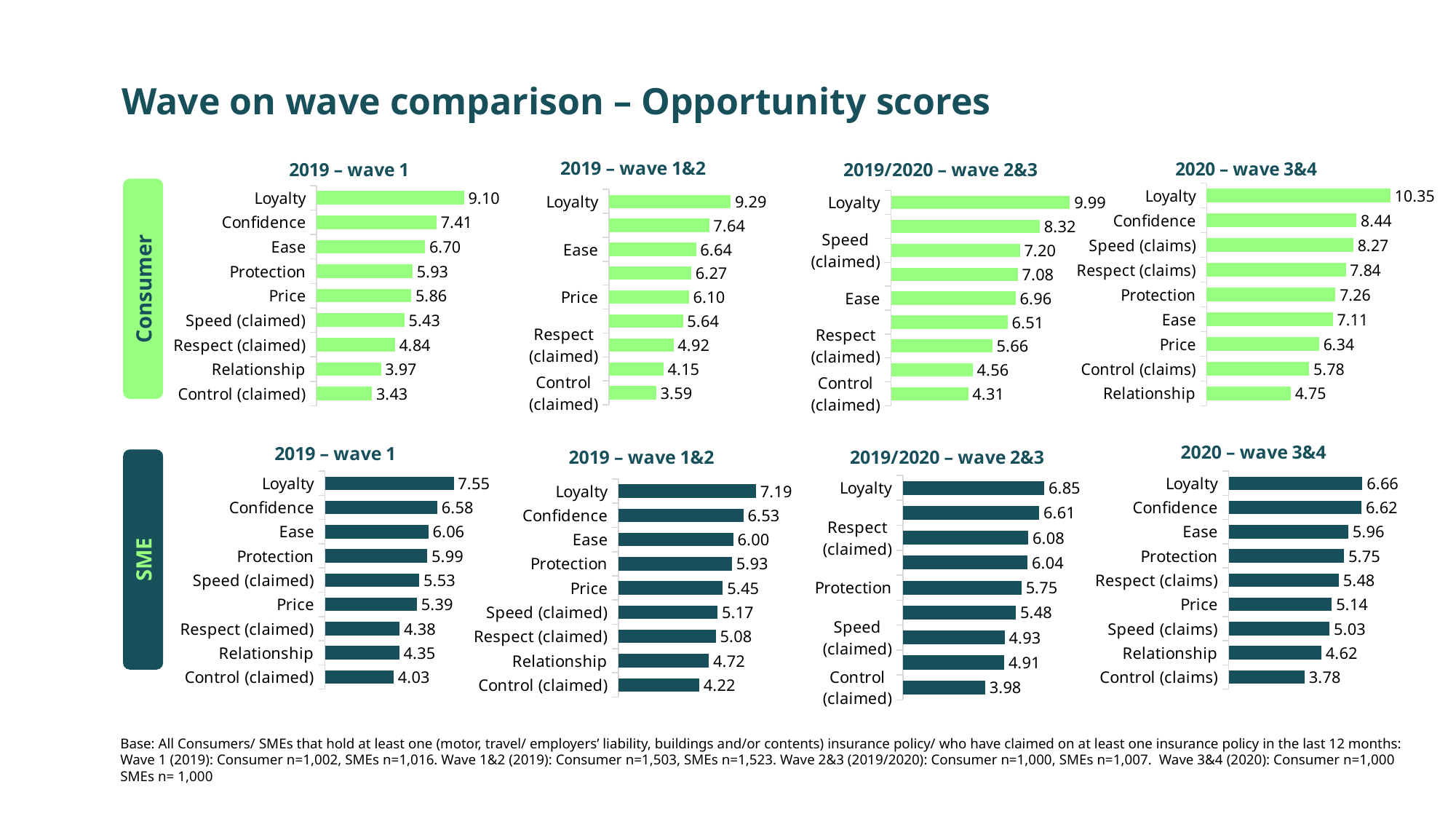
In the Consumer 2019 – wave 1 chart, which is larger, Ease or Protection? Ease What type of chart is used for the SME 2020 – wave 3&4 data? Bar chart In the SME 2019 – wave 1&2 chart, what is the value for Control (claimed)? 4.22 In the Consumer 2019/2020 – wave 2&3 chart, what is the value for Ease? 6.96 In the SME 2020 – wave 3&4 chart, which category has the lowest score? Control (claims) How many charts are shown on the slide in total? 8 In the Consumer 2019 – wave 1 chart, what is the opportunity score for Loyalty? 9.10 How many categories are shown in the Consumer 2019 – wave 1 chart? 9 In the SME 2019 – wave 1 chart, what is the difference between the Loyalty and Confidence scores? 0.97 In the Consumer 2020 – wave 3&4 chart, what is the value for Loyalty? 10.35 In the Consumer 2020 – wave 3&4 chart, what is the value for Relationship? 4.75 In the SME 2019/2020 – wave 2&3 chart, which category has the highest score? Loyalty